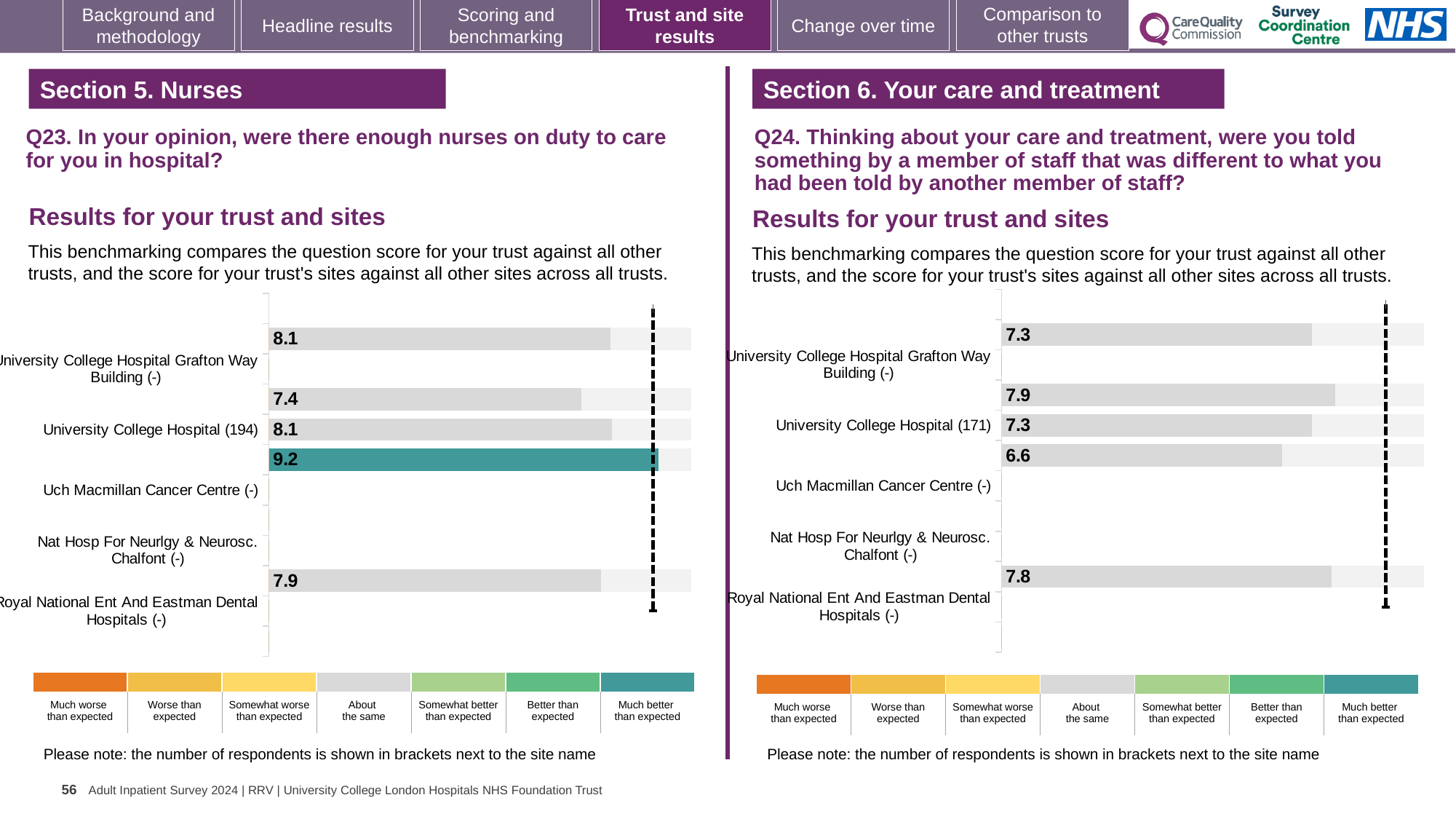
What kind of chart is used for Q23 on the left side of the slide? Bar chart On the left chart (Q23), what is the highest value shown on any bar? 9.2 On the right chart (Q24), what is the difference between the highest bar value (7.9) and the lowest bar value (6.6)? 1.3 On the right chart (Q24), what is the lowest value shown on any bar? 6.6 On the left chart (Q23), what is the lowest value shown on any bar? 7.4 On the left chart (Q23), how many bars with data labels are plotted? 5 How many benchmark categories does the colour legend below each chart list? 7 On the left chart (Q23), what is the difference between the highest bar value (9.2) and the lowest bar value (7.4)? 1.8 On the left chart (Q23), which benchmark category does the colour of the 9.2 bar correspond to in the legend? Much better than expected On the right chart (Q24), what is the value of the bar aligned with University College Hospital (171)? 7.3 On the right chart (Q24), what is the highest value shown on any bar? 7.9 On the left chart (Q23), what is the value of the bar aligned with University College Hospital (194)? 8.1